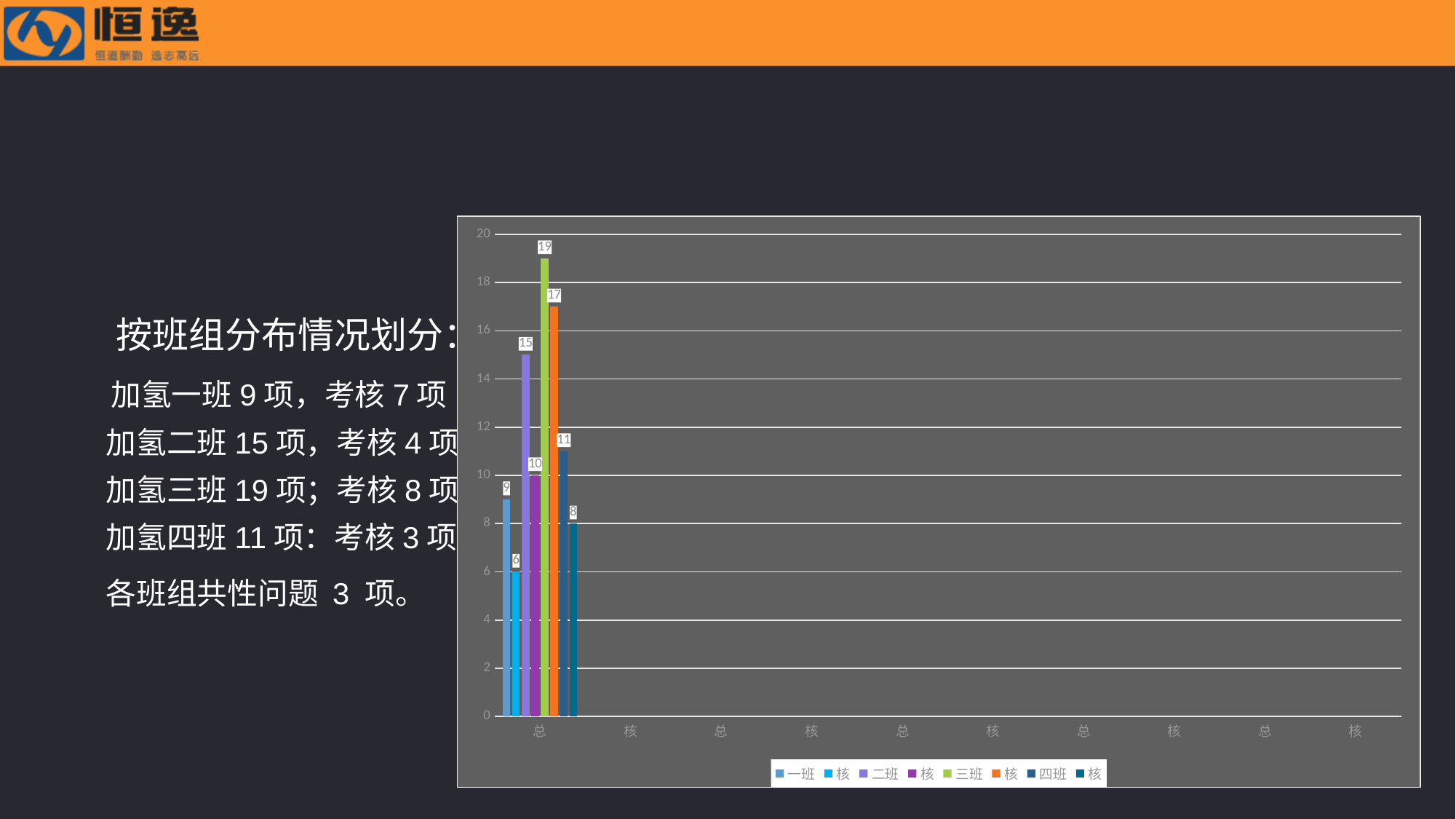
What is the value of the 四班 bar? 11 What is the smallest data label shown on any bar in the chart? 6 How many series does the legend list? 8 Under which x-axis category label are all the bars plotted? 总 What is the value of the 三班 bar? 19 What is the value of the 一班 bar? 9 What is the difference between the 四班 bar and the 一班 bar? 2 Which series has the tallest bar in the chart? 三班 What kind of chart is shown on the slide? bar chart What is the value of the 二班 bar? 15 What is the difference between the 三班 bar and the 二班 bar? 4 Which is larger, the 二班 bar or the 四班 bar? 二班